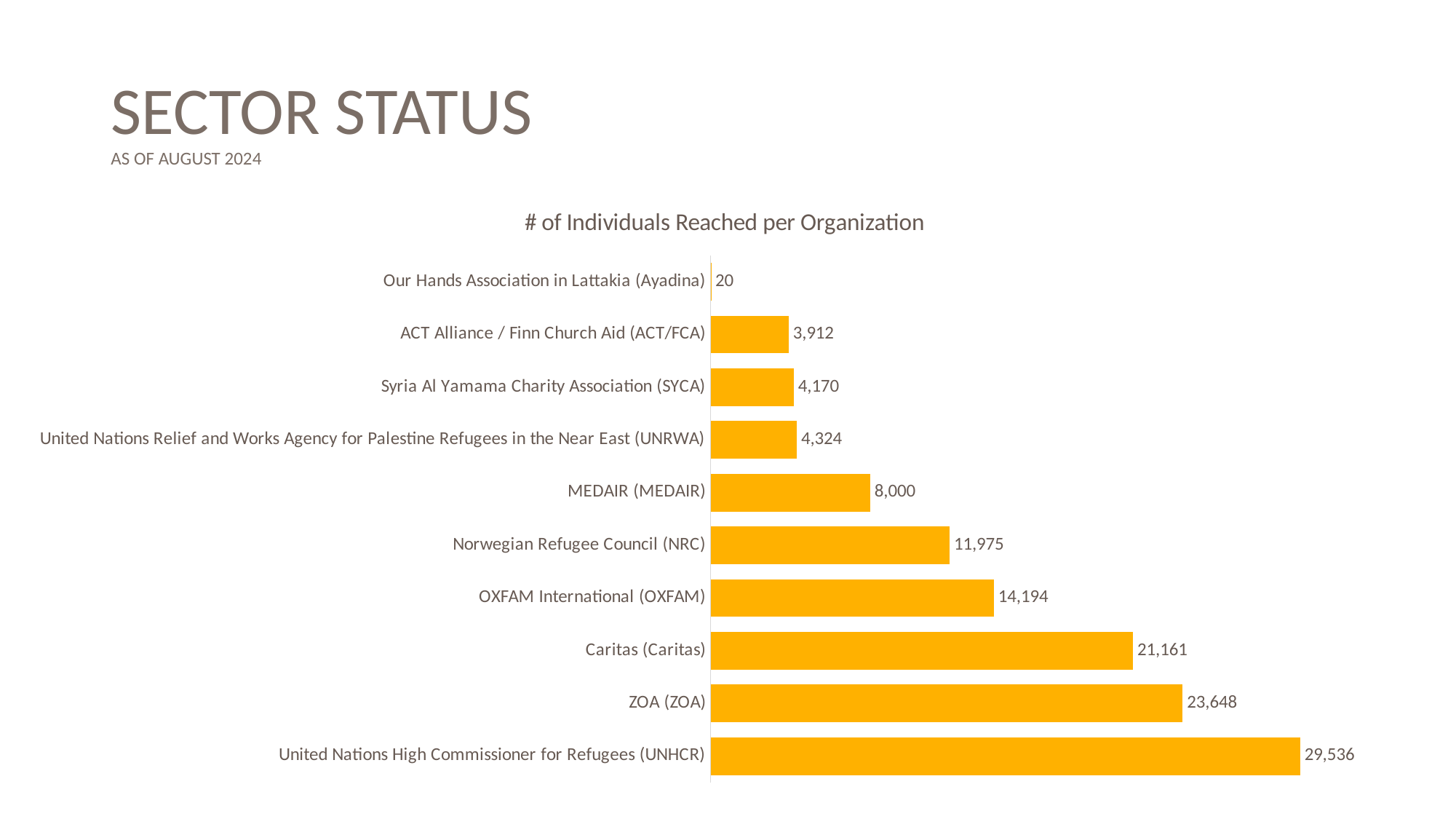
What is the difference between the number of individuals reached by UNHCR and by ZOA (ZOA)? 5,888 Which organization reached the fewest individuals? Our Hands Association in Lattakia (Ayadina) How many organizations are shown in the chart? 10 Which organization reached the most individuals? United Nations High Commissioner for Refugees (UNHCR) What is the title of the chart? # of Individuals Reached per Organization What is the number of individuals reached by MEDAIR (MEDAIR)? 8,000 How many individuals were reached by ZOA (ZOA)? 23,648 What is the difference between the number of individuals reached by Caritas (Caritas) and by OXFAM International (OXFAM)? 6,967 How many individuals were reached by Norwegian Refugee Council (NRC)? 11,975 What colour are the bars in the chart? Orange What type of chart is used to show the number of individuals reached per organization? Bar chart Which reached more individuals, Syria Al Yamama Charity Association (SYCA) or ACT Alliance / Finn Church Aid (ACT/FCA)? Syria Al Yamama Charity Association (SYCA)